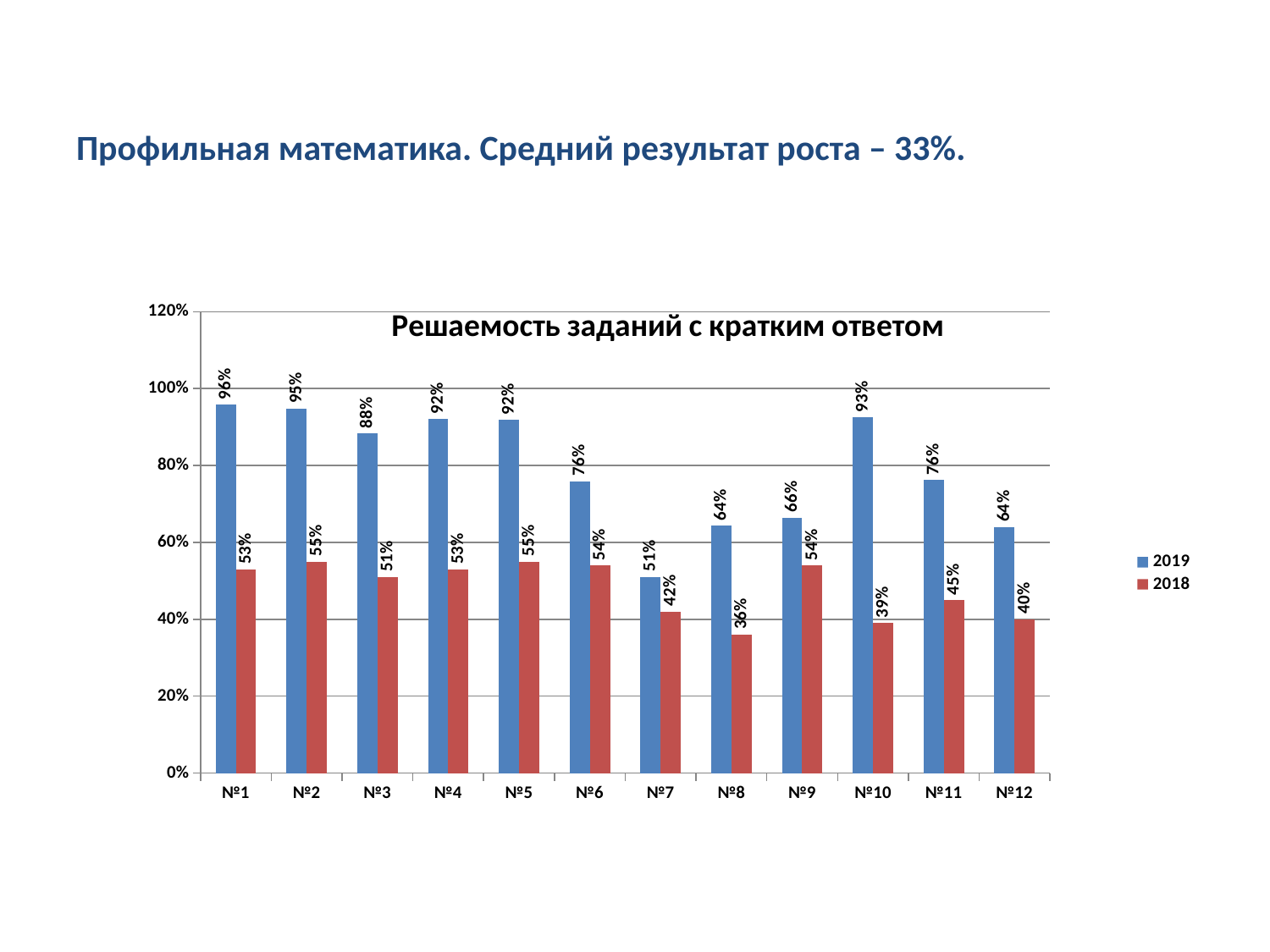
What is the difference between the 2019 and 2018 values for №7? 9% What is the 2019 value for №1? 96% What type of chart is shown? Bar chart Which is larger: the 2019 value for №6 or the 2019 value for №9? 2019 value for №6 What is the 2018 value for №8? 36% Which task has the highest 2019 value? №1 How many tasks (categories) are shown on the x axis? 12 What is the 2019 value for №10? 93% How many series does the legend list? 2 Which task has the lowest 2018 value? №8 Which task has the lowest 2019 value? №7 What is the difference between the 2019 and 2018 values for №10? 54%